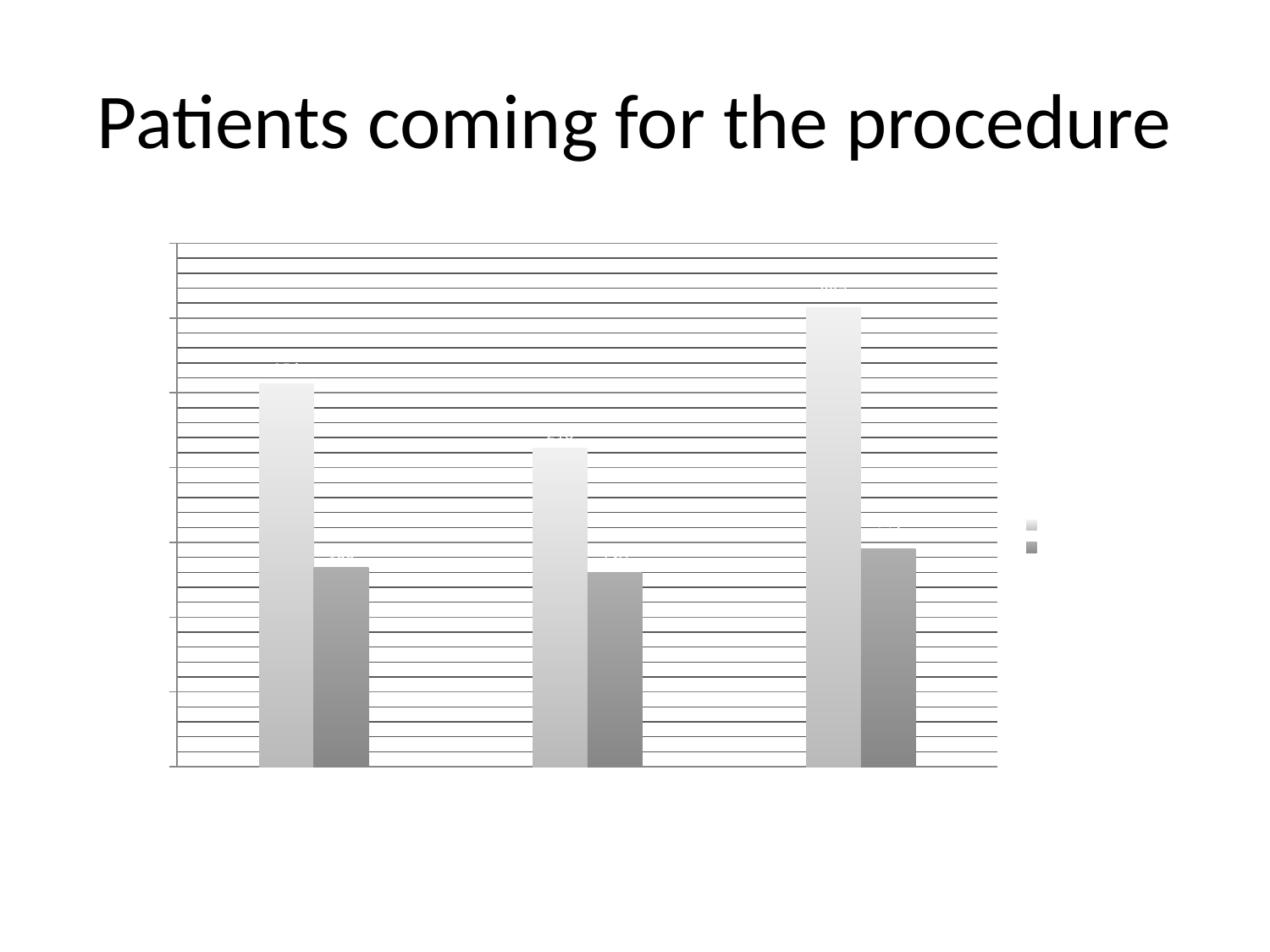
What is the title of the slide containing the chart? Patients coming for the procedure How many series does the legend list? 2 In the third group of bars from the left, which bar is taller, the lighter one or the darker one? the lighter one Which group of bars, counting from the left, has the tallest darker bar? the third group Does the lighter series rise or fall from the second group to the third group? rise How many groups of bars are plotted on the chart? 3 In the first group of bars from the left, which bar is taller, the lighter one or the darker one? the lighter one Which group of bars, counting from the left, has the shortest darker bar? the second group Does the lighter series rise or fall from the first group to the second group? fall What kind of chart is shown on the slide? bar chart Which group of bars, counting from the left, has the tallest lighter bar? the third group Which group of bars, counting from the left, has the shortest lighter bar? the second group